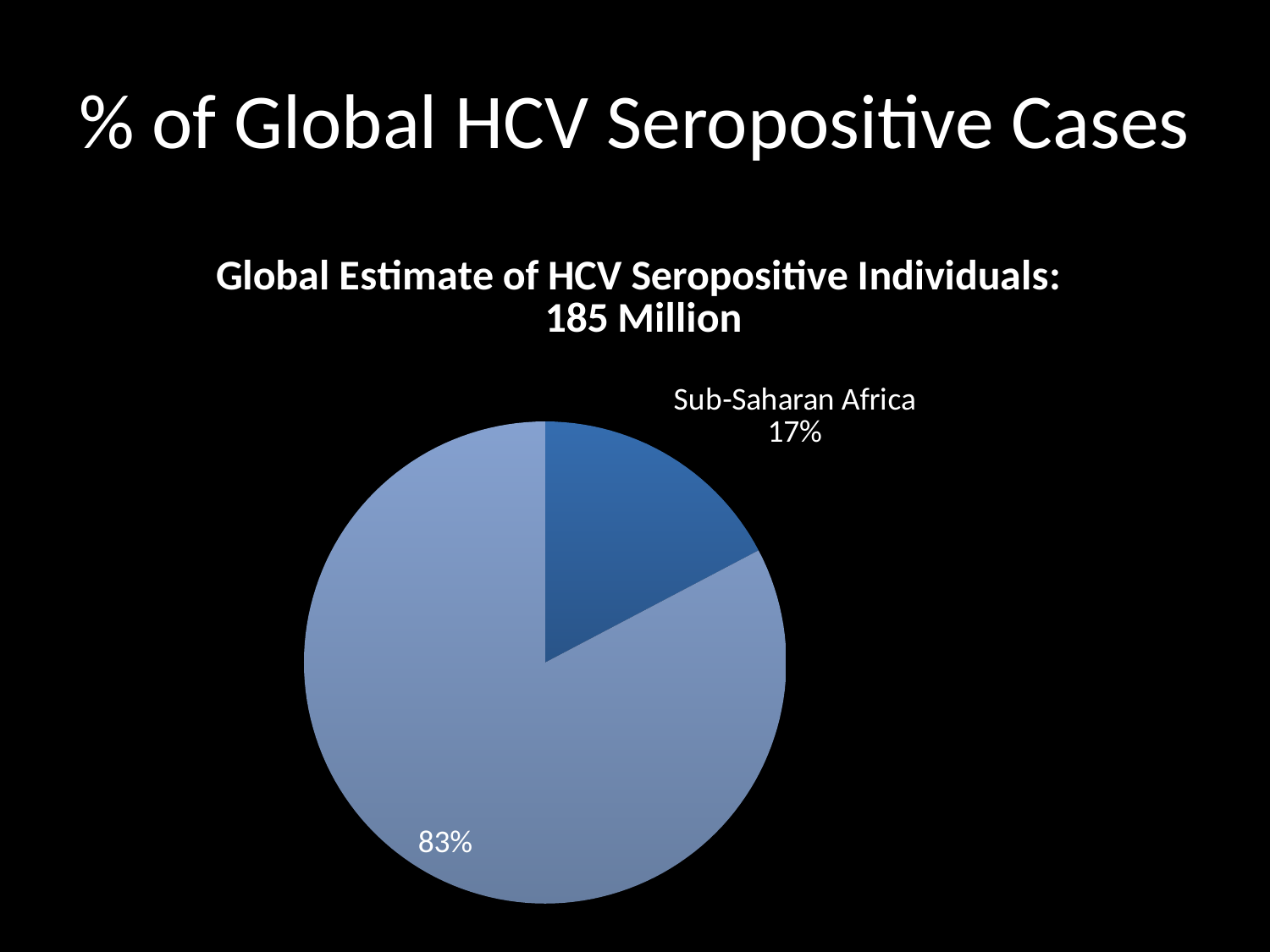
Is the Sub-Saharan Africa slice larger or smaller than the other slice? Smaller Which labelled region is shown as the smaller slice of the pie? Sub-Saharan Africa What kind of chart is shown on the slide? Pie chart How many slices does the pie chart have? 2 What percentage is shown on the larger slice of the pie? 83% What is the title of the chart? Global Estimate of HCV Seropositive Individuals: 185 Million Is the share for Sub-Saharan Africa greater or less than 20%? less What is the difference in percentage points between the larger slice and the Sub-Saharan Africa slice? 66% What global estimate of HCV seropositive individuals is stated in the chart title? 185 Million What share of the pie does Sub-Saharan Africa represent? 17%